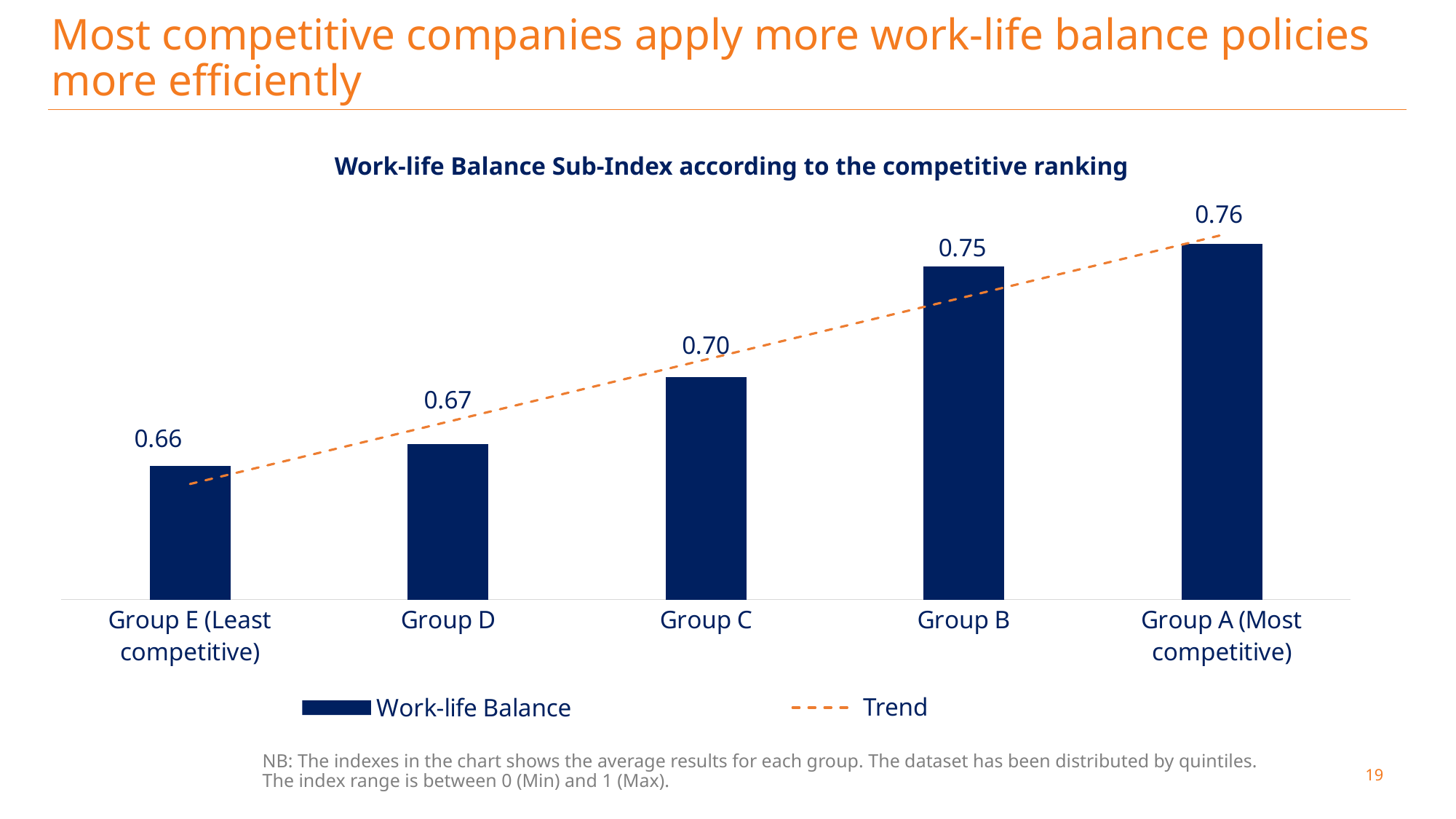
Do the Work-life Balance values rise or fall from Group E to Group A along the x axis? Rise What is the difference between the Work-life Balance values for Group A (Most competitive) and Group E (Least competitive)? 0.10 What is the Work-life Balance value for Group A (Most competitive)? 0.76 Which group has the highest Work-life Balance value? Group A (Most competitive) How many series does the legend list? 2 What is the difference between the Work-life Balance values for Group B and Group D? 0.08 What kind of chart is used to show the Work-life Balance values? Bar chart Which group has the lowest Work-life Balance value? Group E (Least competitive) How many groups are shown on the x axis? 5 What is the Work-life Balance value for Group C? 0.70 Which has a higher Work-life Balance value, Group B or Group C? Group B What is the Work-life Balance value for Group E (Least competitive)? 0.66